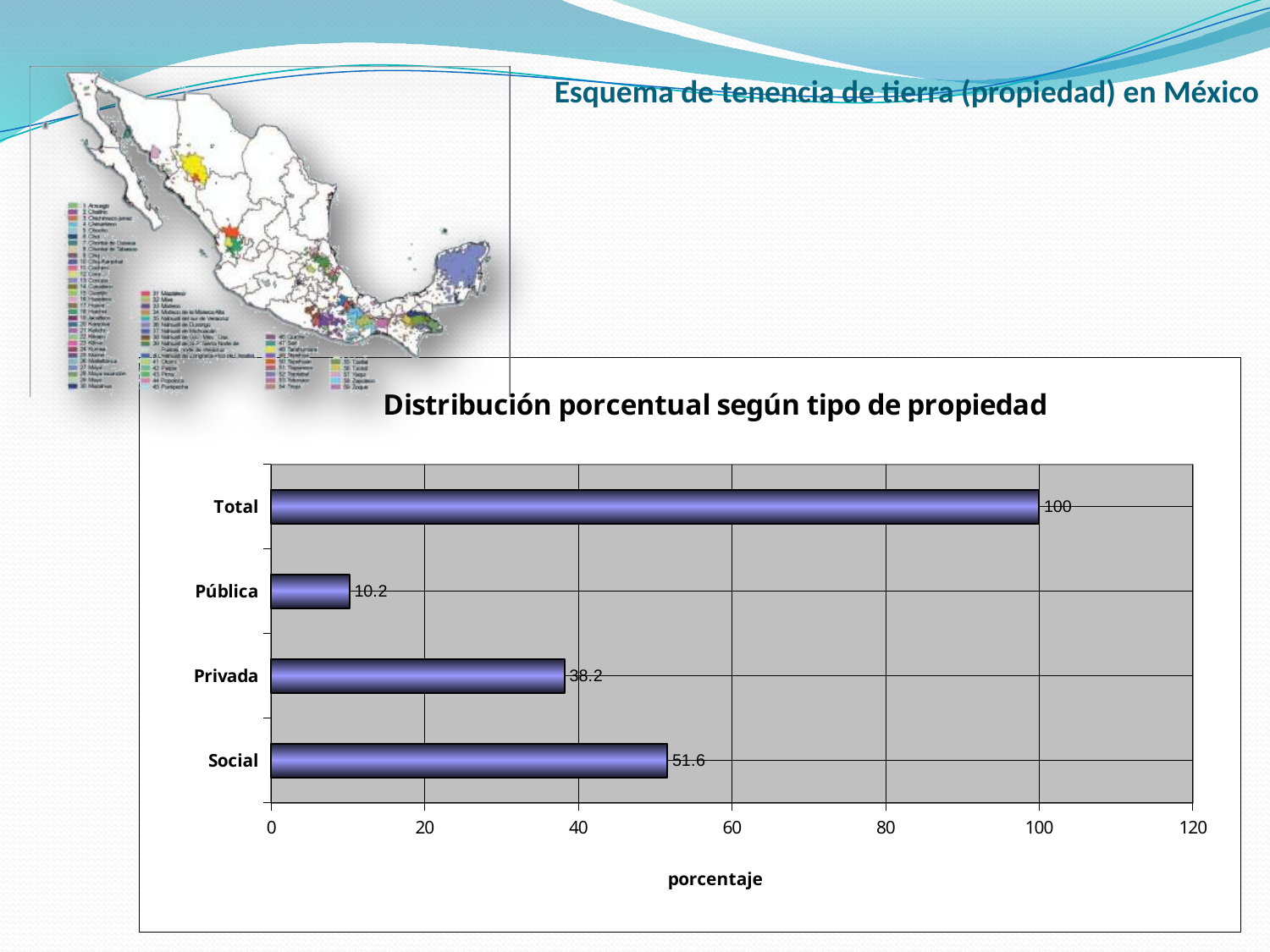
What is the value for Social? 51.6 Is the value for Social greater or less than 40? greater Which is larger, the value for Privada or the value for Pública? Privada What is the title of the chart? Distribución porcentual según tipo de propiedad What is the value for Privada? 38.2 Excluding Total, which category has the highest value? Social What is the difference between the values for Social and Privada? 13.4 What is the value for Pública? 10.2 What is the value for Total? 100 How many categories are shown on the chart? 4 What kind of chart is shown? bar chart Which category has the lowest value? Pública